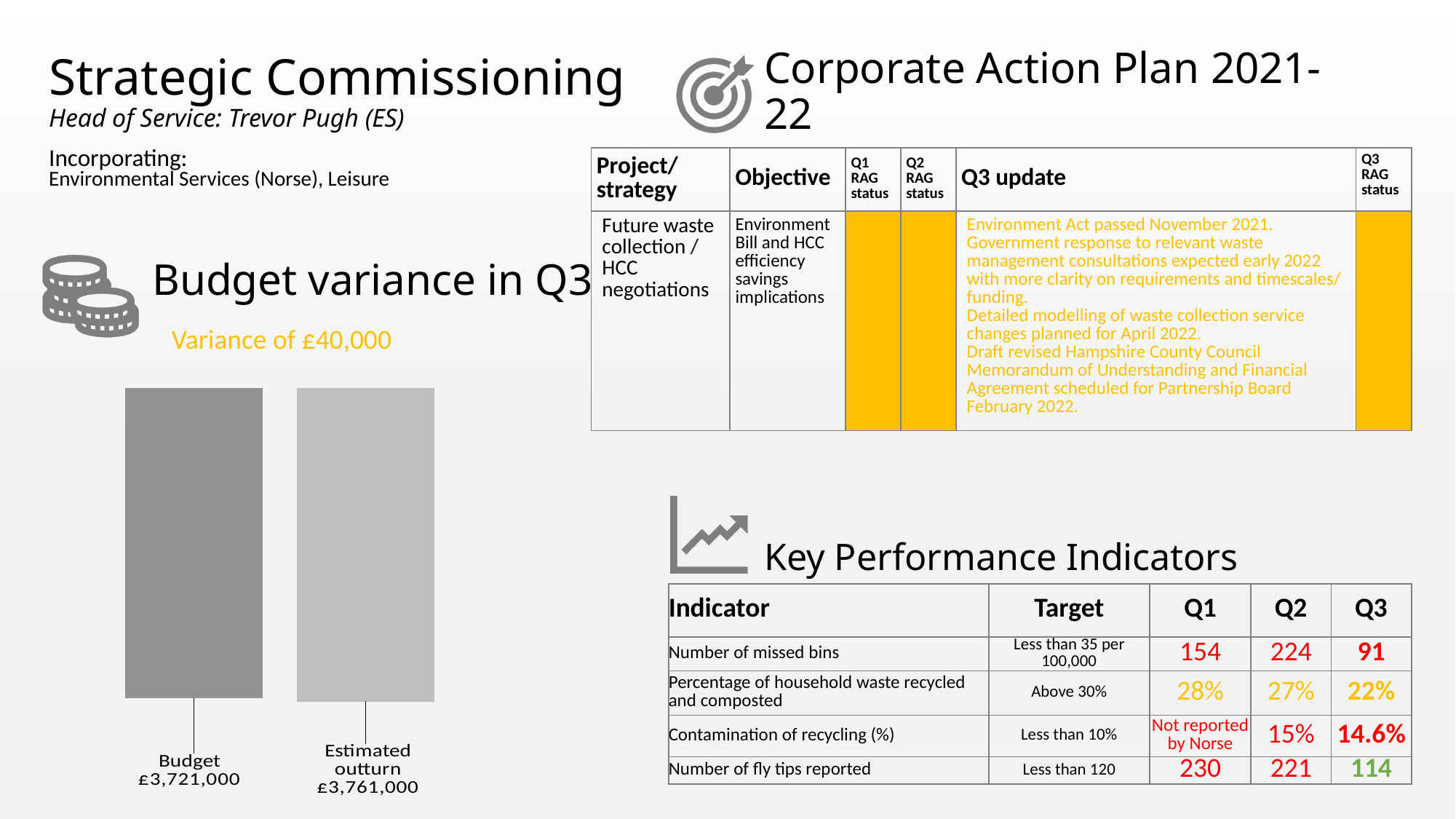
Which bar has the highest value in the Budget variance in Q3 chart? Estimated outturn Which is larger in the Budget variance in Q3 chart, the Budget or the Estimated outturn? Estimated outturn What type of chart is used to show the budget variance in Q3? Bar chart What variance amount is stated above the Budget variance in Q3 chart? Variance of £40,000 How many bars are plotted in the Budget variance in Q3 chart? 2 What is the difference between the Estimated outturn and the Budget in the Budget variance in Q3 chart? £40,000 What is the value of the Estimated outturn bar in the Budget variance in Q3 chart? £3,761,000 What is the value of the Budget bar in the Budget variance in Q3 chart? £3,721,000 What is the title of the bar chart on the slide? Budget variance in Q3 Which bar has the lowest value in the Budget variance in Q3 chart? Budget